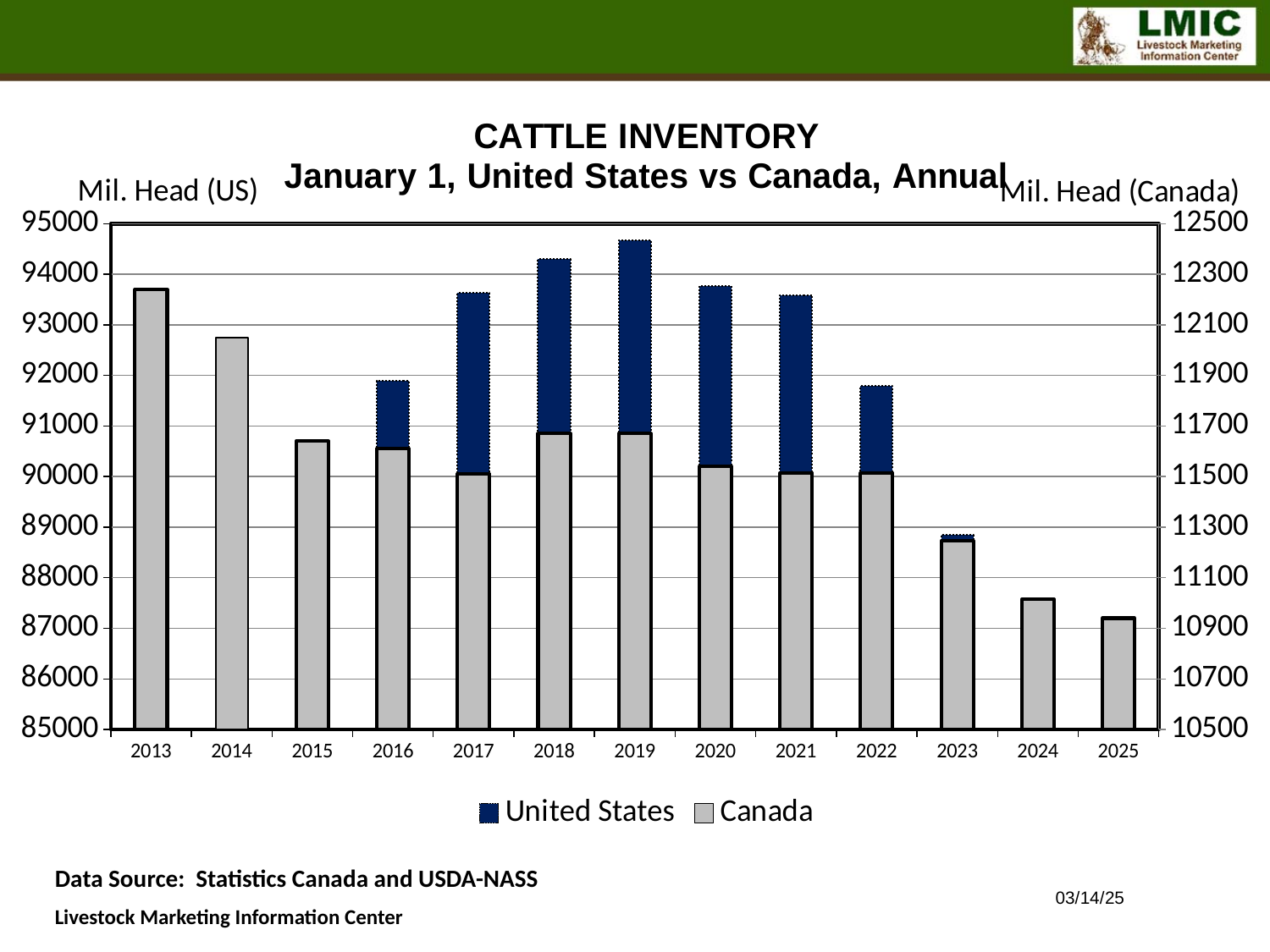
Is the Canada value for 2025 greater or less than 11100? less Which series is shown in dark blue? United States How many years are shown on the x axis of the chart? 13 In which year is the Canada cattle inventory lowest? 2025 Is the United States value for 2019 greater or less than 94000? greater Which is larger, the United States value for 2019 or the United States value for 2022? 2019 In which year is the United States cattle inventory highest? 2019 In which year is the Canada cattle inventory highest? 2013 What kind of chart is shown on the slide? bar chart Is the Canada value for 2013 greater or less than 12100? greater Do the Canada values rise or fall from 2022 to 2025? fall How many series does the legend list? 2